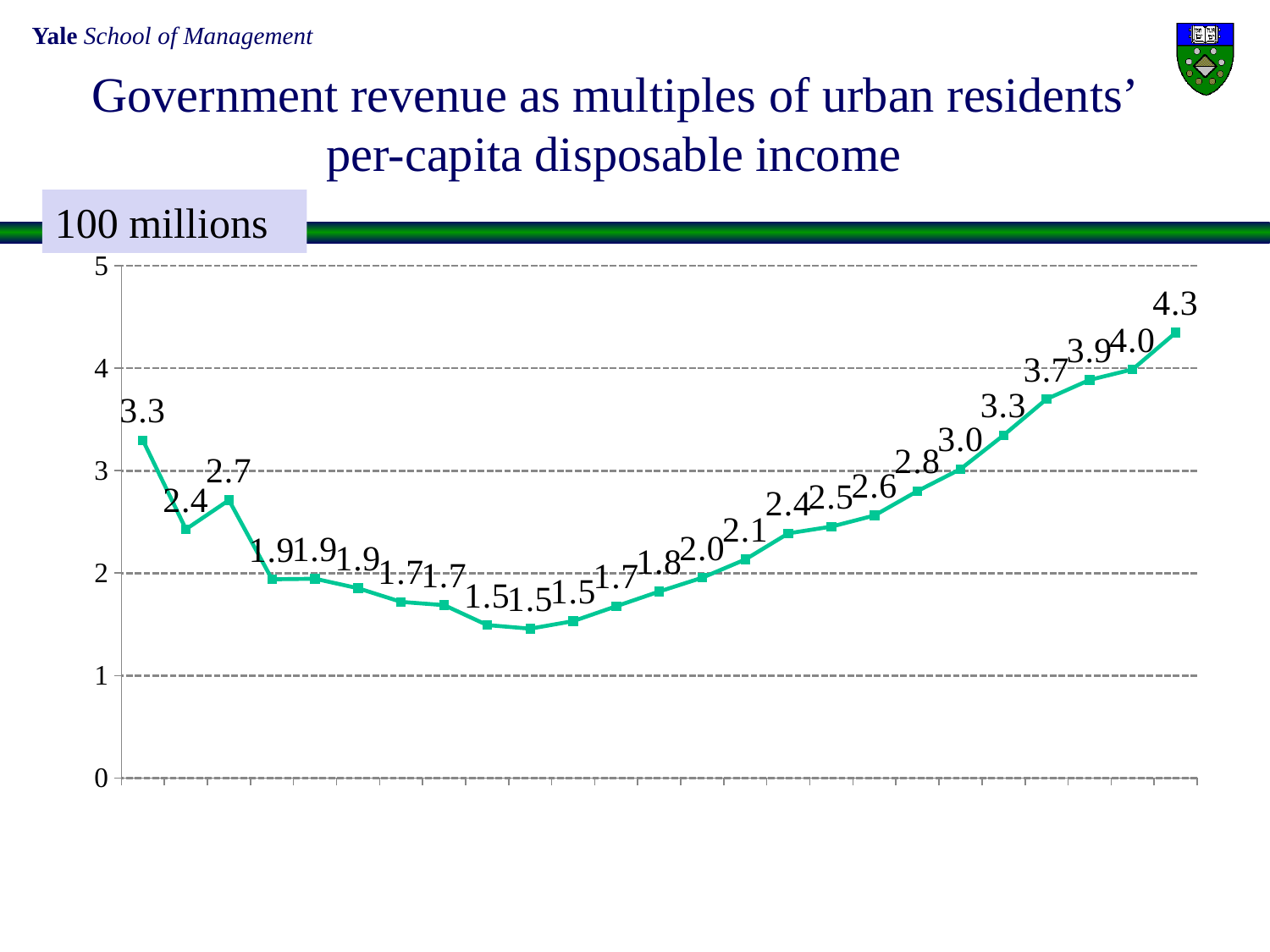
What type of chart is shown on the slide? line chart What is the title of the chart? Government revenue as multiples of urban residents' per-capita disposable income What is the lowest value plotted on the line? 1.5 How many data points are plotted on the line? 25 How do the values change along the x axis? they fall at first, then rise Is the value of the last point on the line greater or less than 4? greater What is the value of the last point on the line? 4.3 What is the highest value plotted on the line? 4.3 Is the lowest point on the line greater or less than 2? less Which is larger, the first point on the line or the last point? the last point What is the value of the first point on the line? 3.3 What is the difference between the last point (4.3) and the first point (3.3)? 1.0